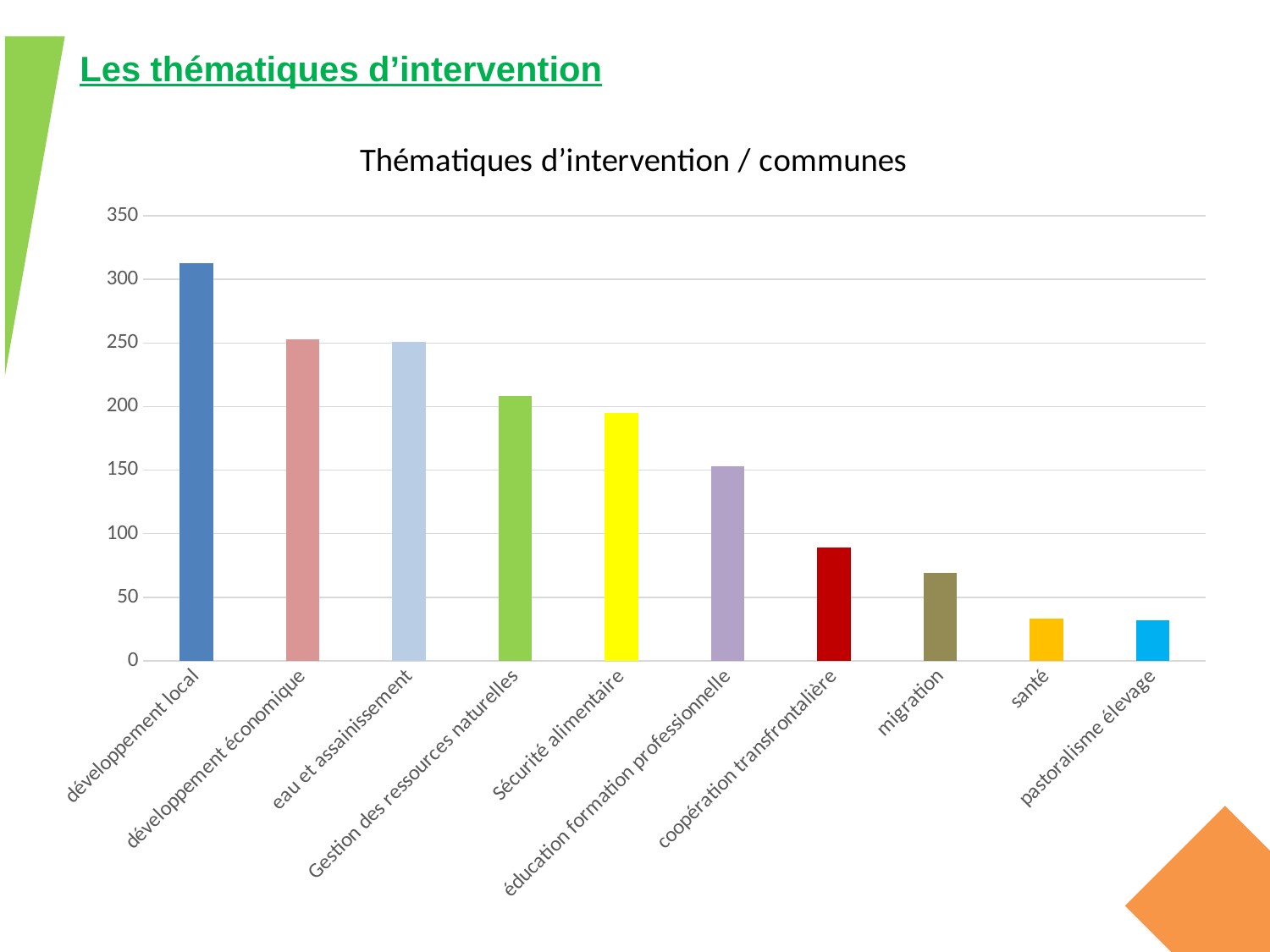
How many categories are plotted in the chart? 10 Is the value for développement local greater or less than 300? greater What is the title of the chart? Thématiques d’intervention / communes Is the value for Gestion des ressources naturelles greater or less than 200? greater Which is larger, the value for éducation formation professionnelle or the value for migration? éducation formation professionnelle Which is larger, the value for Sécurité alimentaire or the value for coopération transfrontalière? Sécurité alimentaire Is the value for coopération transfrontalière greater or less than 100? less Which category has the highest value? développement local Do the values rise or fall from left to right along the x axis? fall What kind of chart is shown on the slide? bar chart